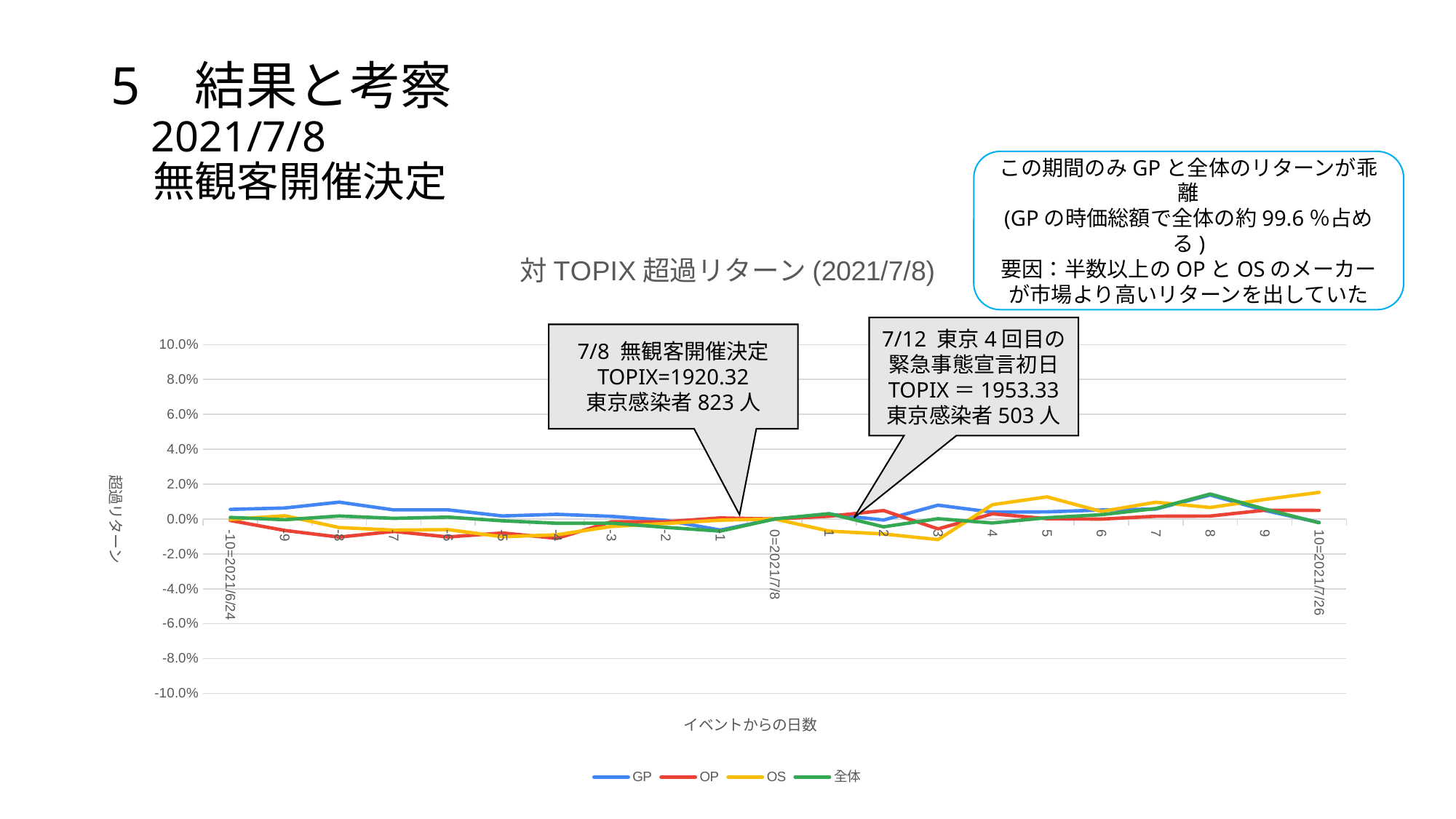
Is the value for OP at day -8 greater or less than 0.0%? less What kind of chart is shown on the slide? line chart Is the value for OS at day 10 greater or less than 0.0%? greater How many series does the legend list? 4 Which series has the highest value at day 10? OS Which series has the lowest value at day 3? OS How many points are plotted along the x axis for each series (from -10 to 10)? 21 Which series has the highest value at day -8? GP What is the title of the chart? 対 TOPIX 超過リターン (2021/7/8) What are the four series named in the legend? GP, OP, OS, 全体 At day 8, which is larger, the value for 全体 or the value for OP? 全体